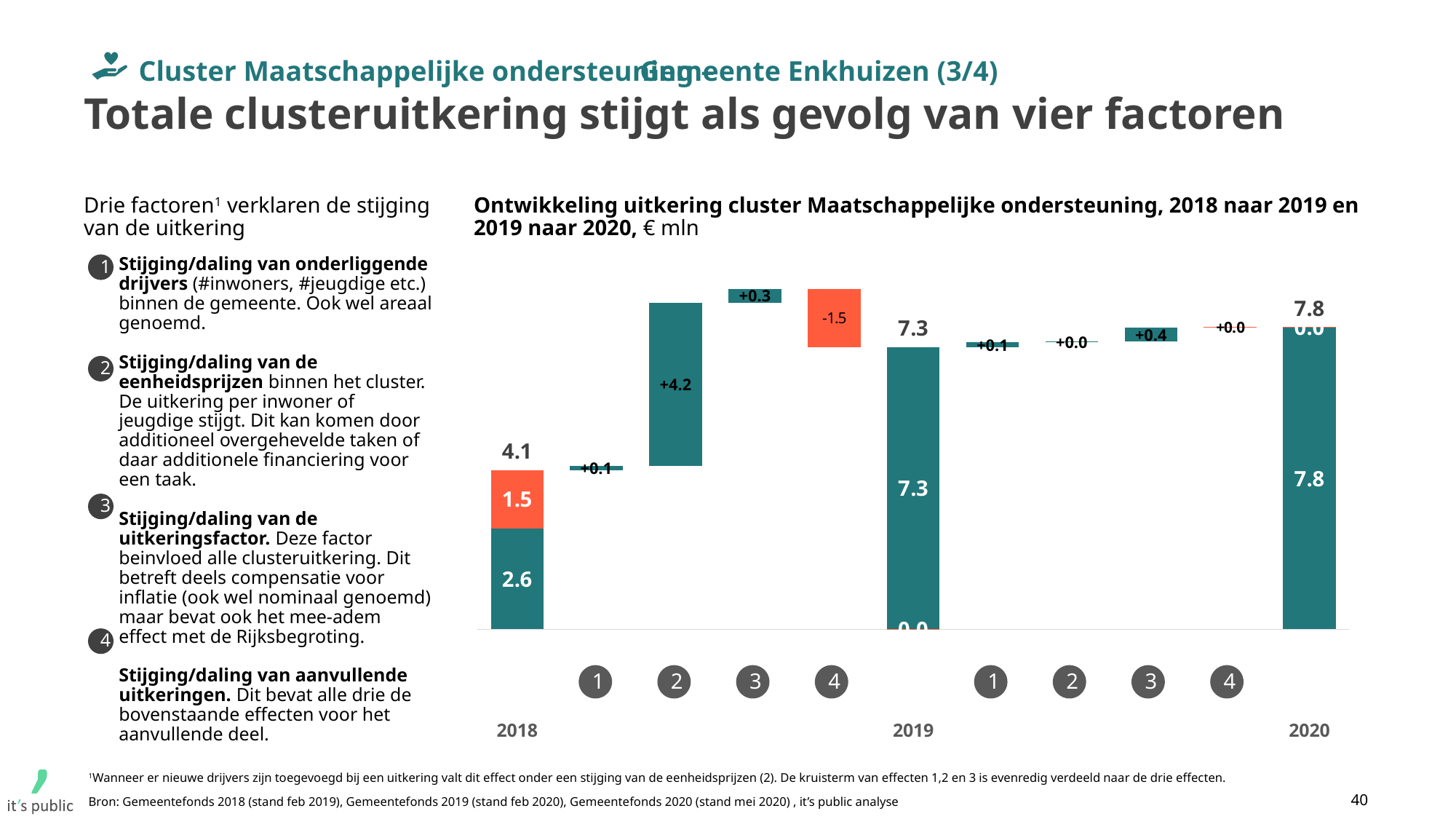
What is the total uitkering shown for 2018 in the chart? 4.1 In what unit are the values in the chart expressed? € mln What is the value of factor 3 (uitkeringsfactor) in the step from 2019 to 2020? +0.4 What is the sum of the two segments of the 2018 bar (2.6 and 1.5)? 4.1 Which of the four factors has the lowest value in the step from 2018 to 2019? Factor 4 (-1.5) What is the value of factor 4 (aanvullende uitkeringen) in the step from 2018 to 2019? -1.5 Which of the four factors has the largest effect in the step from 2018 to 2019? Factor 2 (+4.2) Is the total for 2019 larger or smaller than the total for 2020? Smaller What is the total uitkering shown for 2019 in the chart? 7.3 What is the total uitkering shown for 2020 in the chart? 7.8 By how much did the total uitkering increase from 2018 to 2020? 3.7 What is the value of factor 2 (eenheidsprijzen) in the step from 2018 to 2019? +4.2